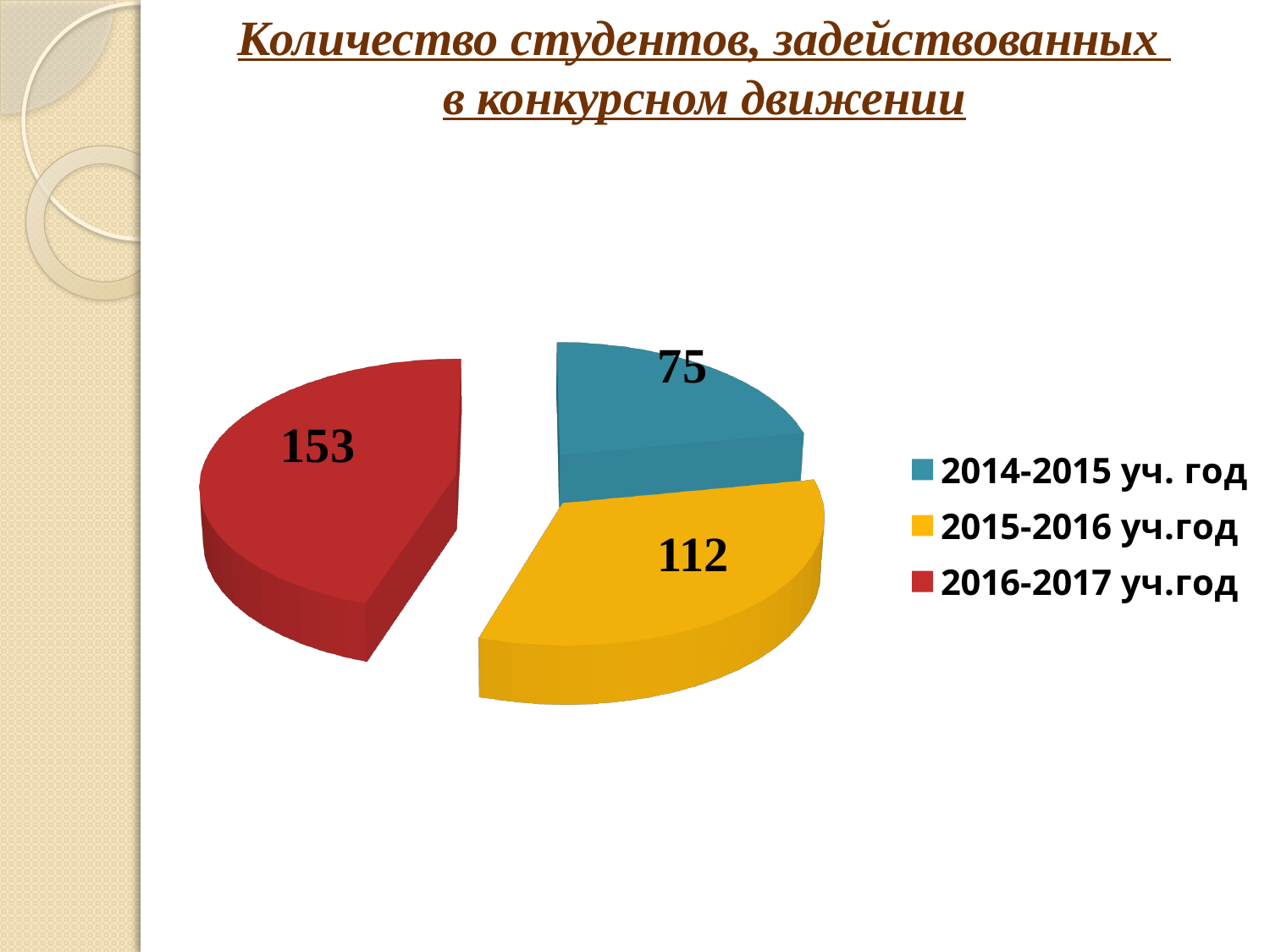
What is the value for 2014-2015 уч. год? 75 Which is larger, the value for 2015-2016 уч.год or 2014-2015 уч. год? 2015-2016 уч.год How many entries does the legend list? 3 What is the total of all three slices in the pie chart? 340 What colour is the slice for 2016-2017 уч.год? Red How many slices does the pie chart have? 3 What is the value for 2016-2017 уч.год? 153 What is the difference between the values for 2016-2017 уч.год and 2014-2015 уч. год? 78 Which academic year has the largest number of students? 2016-2017 уч.год What type of chart is shown on the slide? Pie chart Which academic year has the smallest number of students? 2014-2015 уч. год What is the value for 2015-2016 уч.год? 112